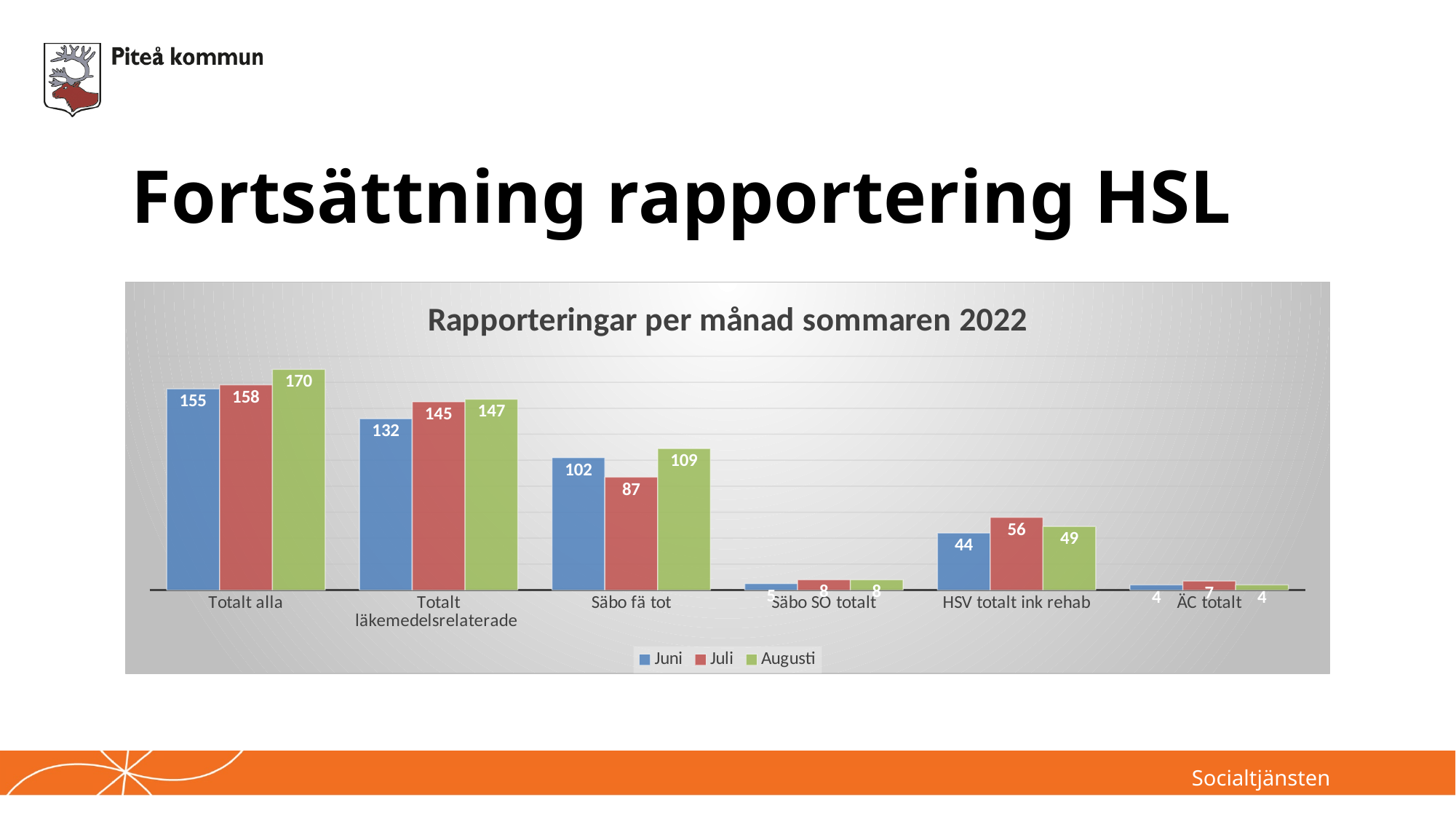
What is the Juli value for Säbo fä tot? 87 What is the Juli value for HSV totalt ink rehab? 56 What is the difference between the Augusti and Juni values for Totalt alla? 15 Which is larger for Säbo fä tot: the Juni value or the Augusti value? Augusti What type of chart is shown on the slide? Bar chart What is the Augusti value for Totalt alla? 170 How many series does the legend list? 3 What is the Juni value for Totalt läkemedelsrelaterade? 132 Which month has the highest value for Totalt alla? Augusti How many categories are shown on the x axis? 6 Which month has the lowest value for Säbo fä tot? Juli What is the difference between the Juli and Juni values for HSV totalt ink rehab? 12